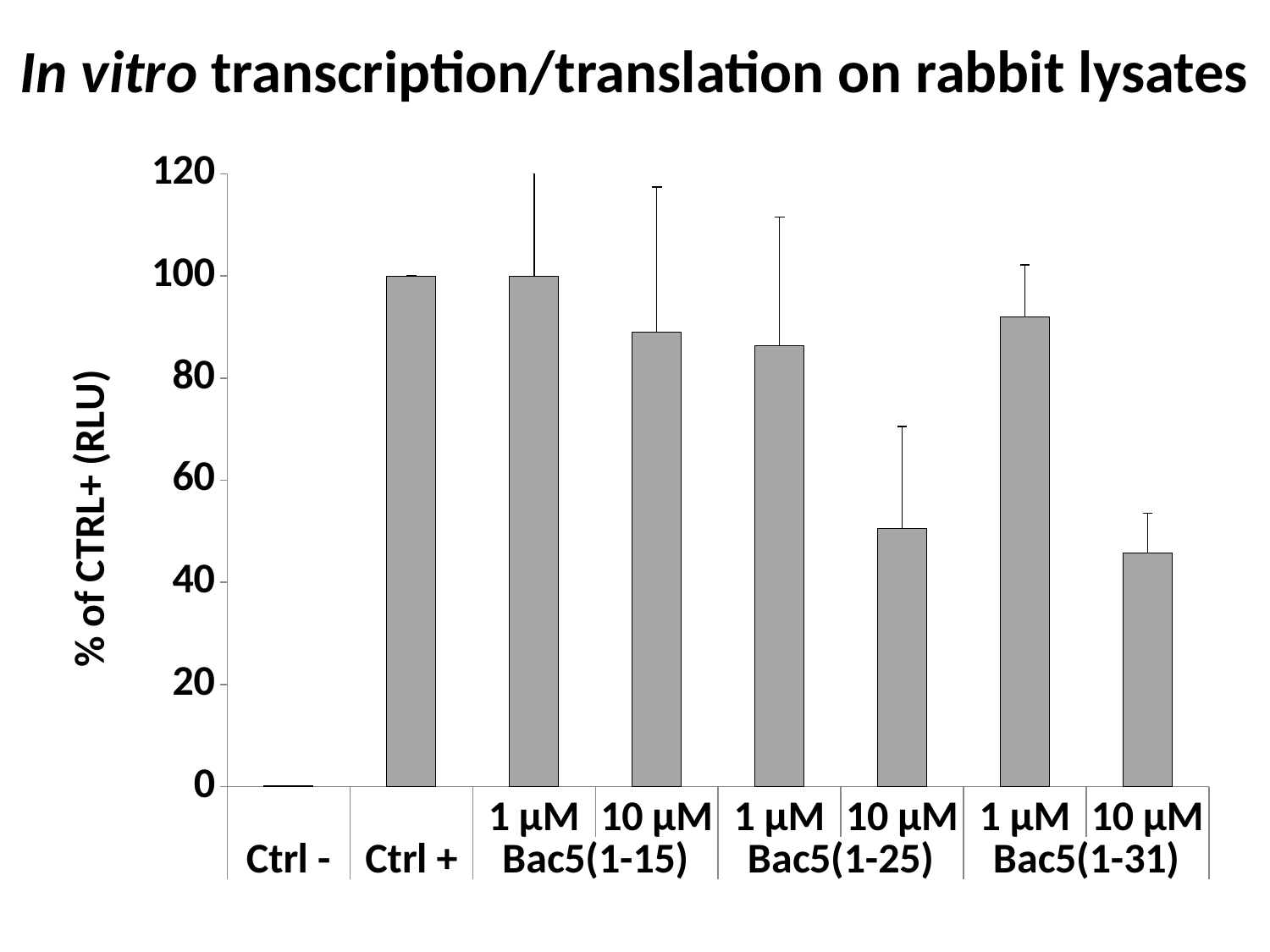
What is the value for Ctrl + in the chart? 100 What is the label of the y axis? % of CTRL+ (RLU) Which is larger, the value for 1 µM Bac5(1-31) or the value for 10 µM Bac5(1-31)? 1 µM Bac5(1-31) Is the value for 10 µM Bac5(1-25) greater or less than 60? less How many bars (categories) are plotted in the chart? 8 Which is larger, the value for 10 µM Bac5(1-15) or the value for 10 µM Bac5(1-25)? 10 µM Bac5(1-15) Is the value for 10 µM Bac5(1-31) greater or less than 60? less Is the value for 10 µM Bac5(1-15) greater or less than 80? greater What kind of chart is shown on the slide? bar chart Which category has the lowest value in the chart? Ctrl - What is the value for Ctrl - in the chart? 0